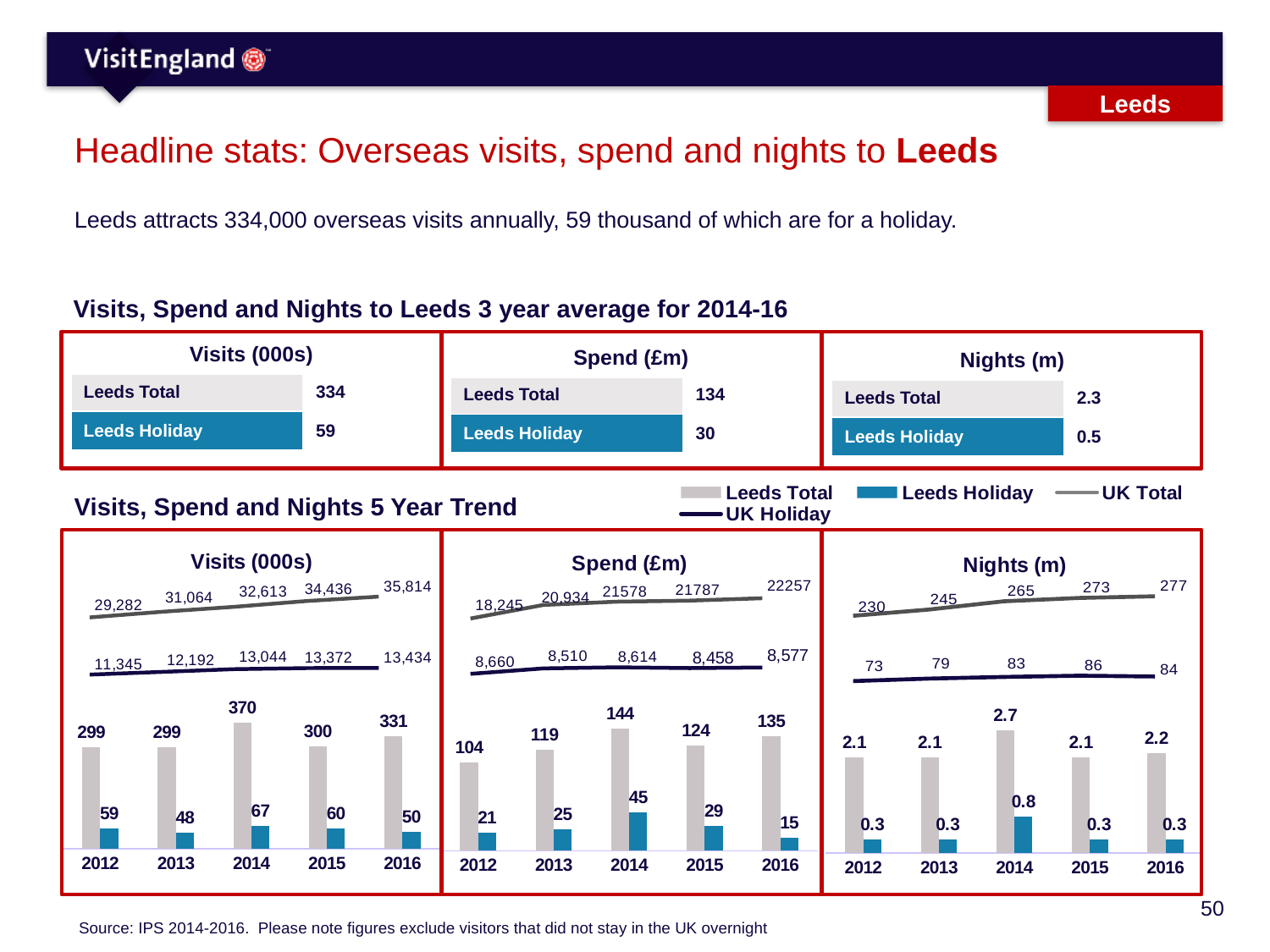
In the Visits (000s) 5 year trend chart, what is the UK Holiday value for 2013? 12,192 In the Nights (m) 5 year trend chart, what is the UK Total value for 2016? 277 How many series does the legend above the 5 year trend charts list? 4 In the Visits (000s) 5 year trend chart, does the UK Total line rise or fall from 2012 to 2016? rise In the Spend (£m) 5 year trend chart, what is the difference between the Leeds Total values for 2014 and 2012? 40 In the Spend (£m) 5 year trend chart, what is the Leeds Holiday value for 2016? 15 In the Nights (m) 5 year trend chart, is the Leeds Holiday value for 2014 larger or smaller than the value for 2015? larger What kind of chart is used for the Leeds Total and Leeds Holiday series in the 5 year trend charts? bar chart In the Spend (£m) 5 year trend chart, which year has the lowest Leeds Holiday value? 2016 In the Visits (000s) 5 year trend chart, which year has the highest Leeds Total value? 2014 In the Visits (000s) 5 year trend chart, what is the Leeds Total value for 2014? 370 How many years are shown on the x axis of the Visits (000s) 5 year trend chart? 5